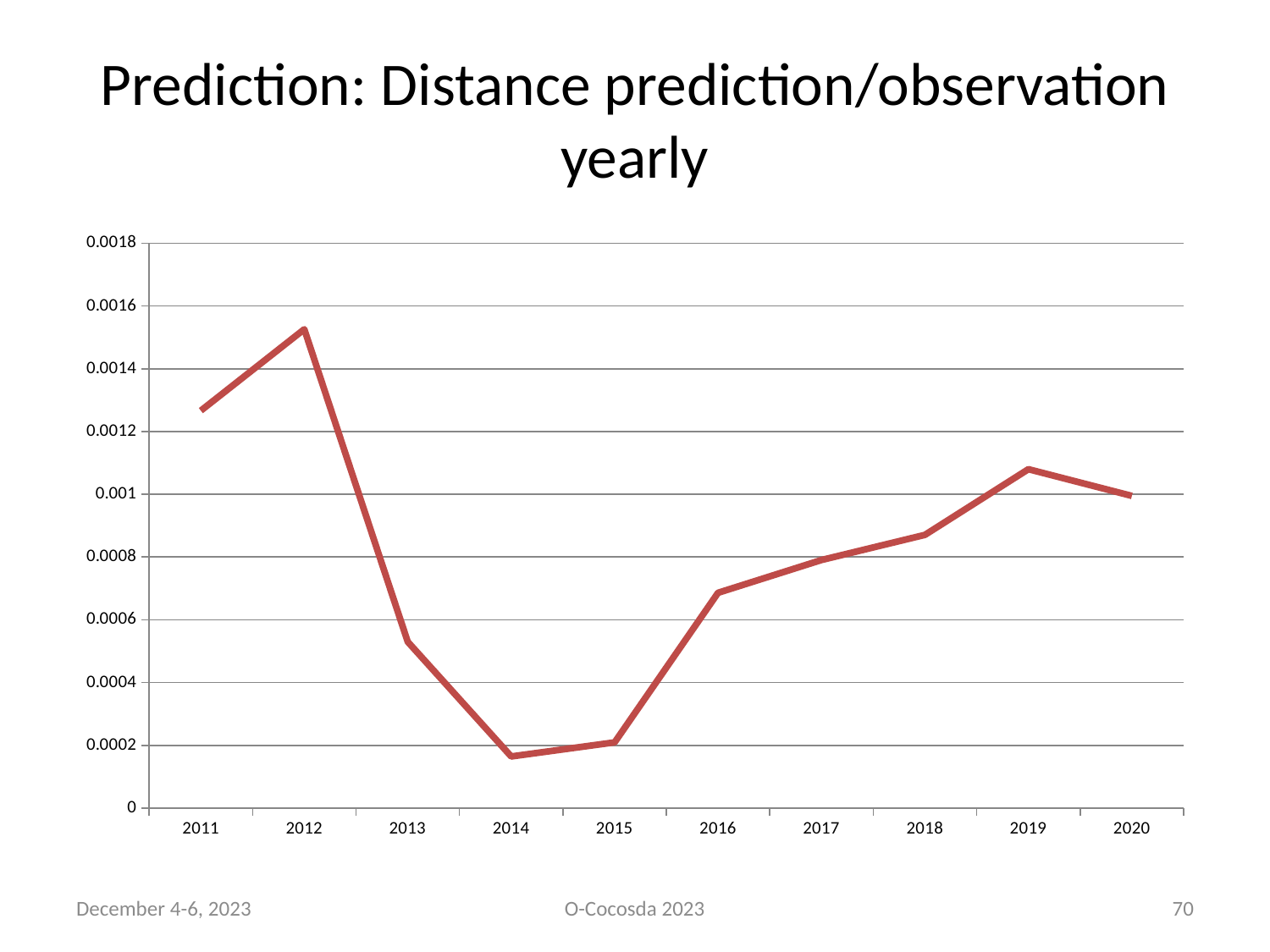
How many years are plotted along the x axis? 10 Which year has the lowest value? 2014 Which year has the highest value? 2012 Is the value for 2019 greater or less than 0.001? greater Which year has the larger value, 2011 or 2016? 2011 What is the title of the chart? Prediction: Distance prediction/observation yearly Is the value for 2013 greater or less than 0.0006? less Do the values rise or fall from 2012 to 2014? fall Is the value for 2012 greater or less than 0.0014? greater Do the values rise or fall from 2015 to 2019? rise What kind of chart is shown on the slide? line chart